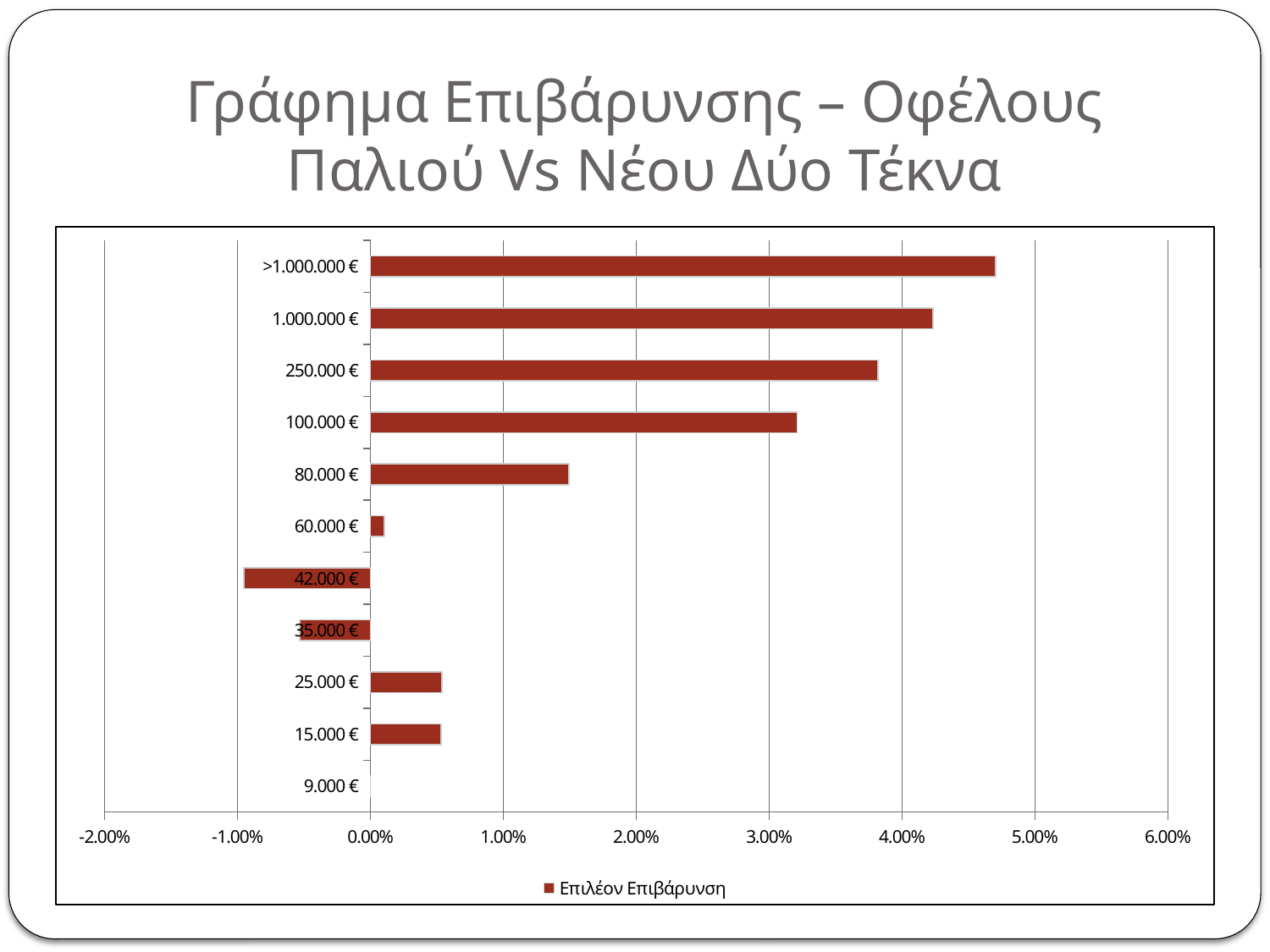
Which has the larger value, 100.000 € or 80.000 €? 100.000 € Is the value for 100.000 € greater or less than 3.00%? greater How many series does the legend list? 1 What kind of chart is shown on the slide? bar chart Is the value for 42.000 € greater or less than 0.00%? less Is the value for >1.000.000 € greater or less than 4.00%? greater Which category has the lowest value? 42.000 € Which category has the highest value? >1.000.000 € What is the name of the series shown in the legend? Επιλέον Επιβάρυνση Which has the larger value, 1.000.000 € or 250.000 €? 1.000.000 € How many income categories are plotted on the chart? 11